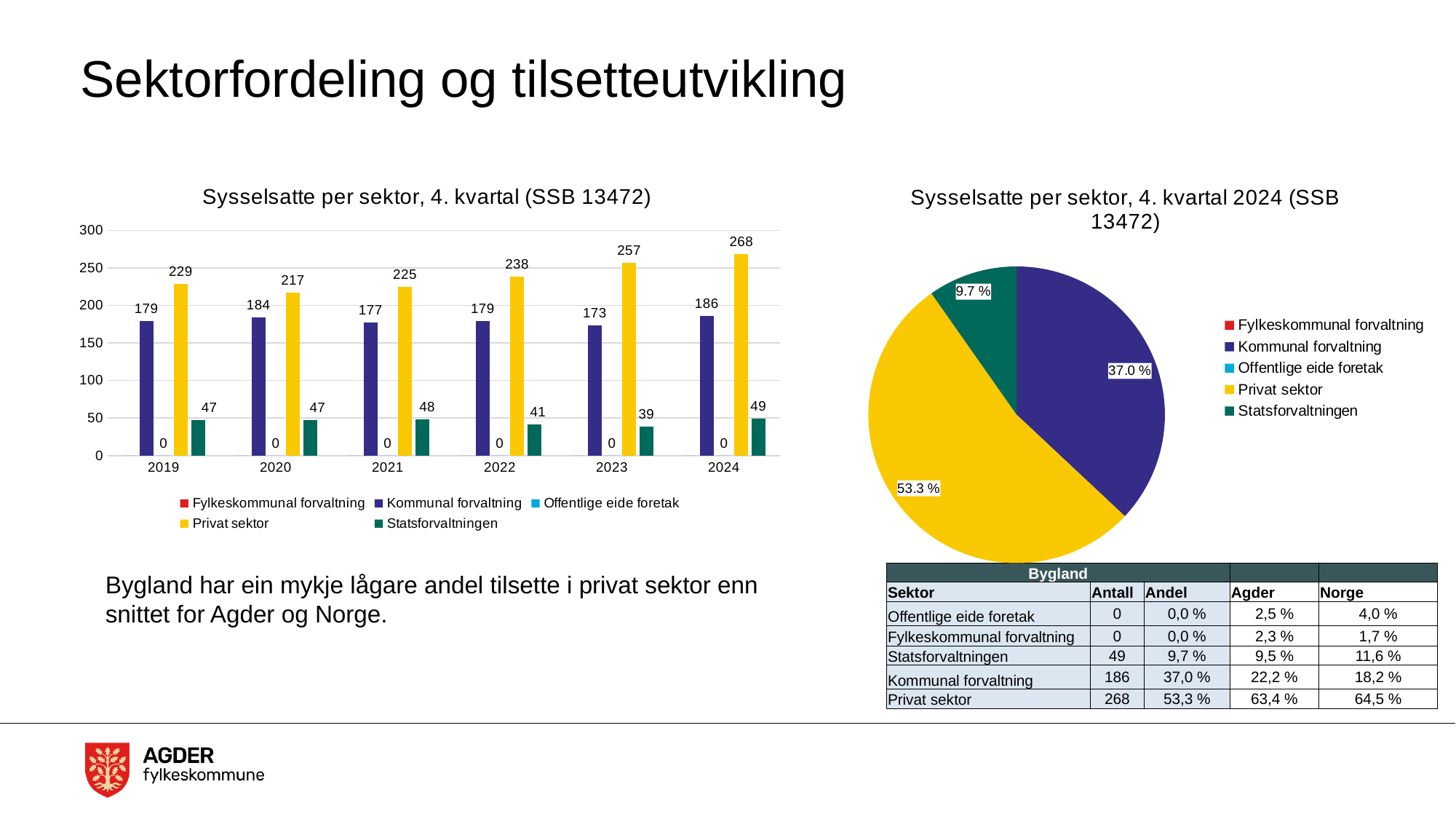
In the bar chart 'Sysselsatte per sektor, 4. kvartal (SSB 13472)', what is the value for Statsforvaltningen in 2023? 39 In the bar chart 'Sysselsatte per sektor, 4. kvartal (SSB 13472)', which year has the highest value for Privat sektor? 2024 In the bar chart 'Sysselsatte per sektor, 4. kvartal (SSB 13472)', does the value for Privat sektor rise or fall from 2021 to 2024? rise In the pie chart 'Sysselsatte per sektor, 4. kvartal 2024 (SSB 13472)', what share does Privat sektor have? 53.3 % In the bar chart 'Sysselsatte per sektor, 4. kvartal (SSB 13472)', what is the difference between Privat sektor and Kommunal forvaltning in 2024? 82 In the bar chart 'Sysselsatte per sektor, 4. kvartal (SSB 13472)', what is the value for Privat sektor in 2024? 268 In the bar chart 'Sysselsatte per sektor, 4. kvartal (SSB 13472)', which is larger in 2020: Kommunal forvaltning or Privat sektor? Privat sektor In the bar chart 'Sysselsatte per sektor, 4. kvartal (SSB 13472)', which year has the lowest value for Statsforvaltningen? 2023 How many series does the legend of the bar chart 'Sysselsatte per sektor, 4. kvartal (SSB 13472)' list? 5 What kind of chart is 'Sysselsatte per sektor, 4. kvartal 2024 (SSB 13472)' on the right of the slide? pie chart How many years are shown on the x axis of the bar chart 'Sysselsatte per sektor, 4. kvartal (SSB 13472)'? 6 In the bar chart 'Sysselsatte per sektor, 4. kvartal (SSB 13472)', what is the value for Kommunal forvaltning in 2021? 177